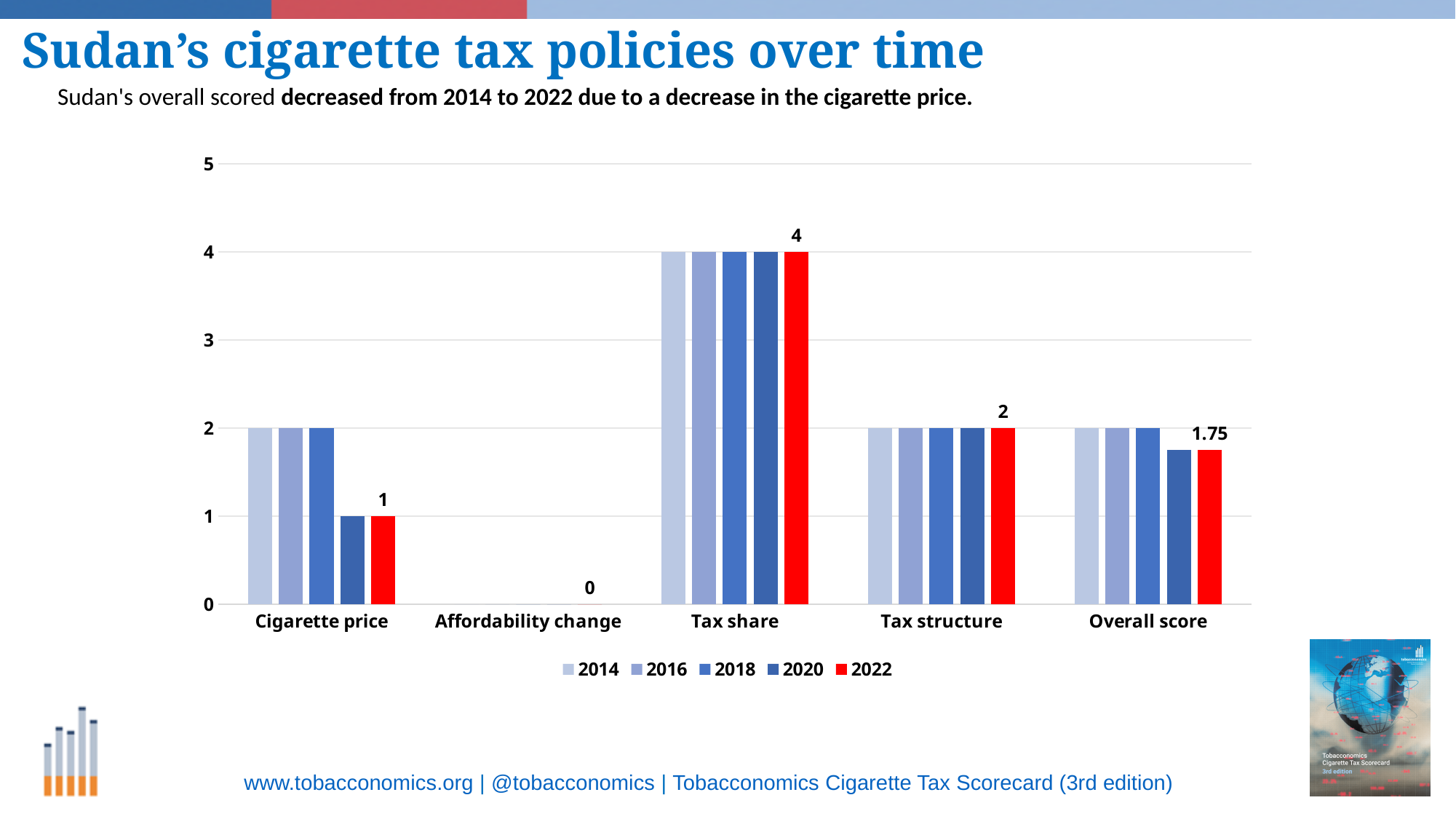
Does the Cigarette price score rise or fall from 2014 to 2022? fall How many categories are shown on the x axis? 5 How many series does the legend list? 5 What is the value for Tax structure in 2022? 2 What is the difference between the 2022 values for Tax share and Tax structure? 2 What is the value for Cigarette price in 2022? 1 What is the value for Affordability change in 2022? 0 Which category has the lowest value in 2022? Affordability change What is the value for Tax share in 2022? 4 Which is larger in 2022, Cigarette price or Tax structure? Tax structure Which category has the highest value in 2022? Tax share What is the Overall score for 2022? 1.75